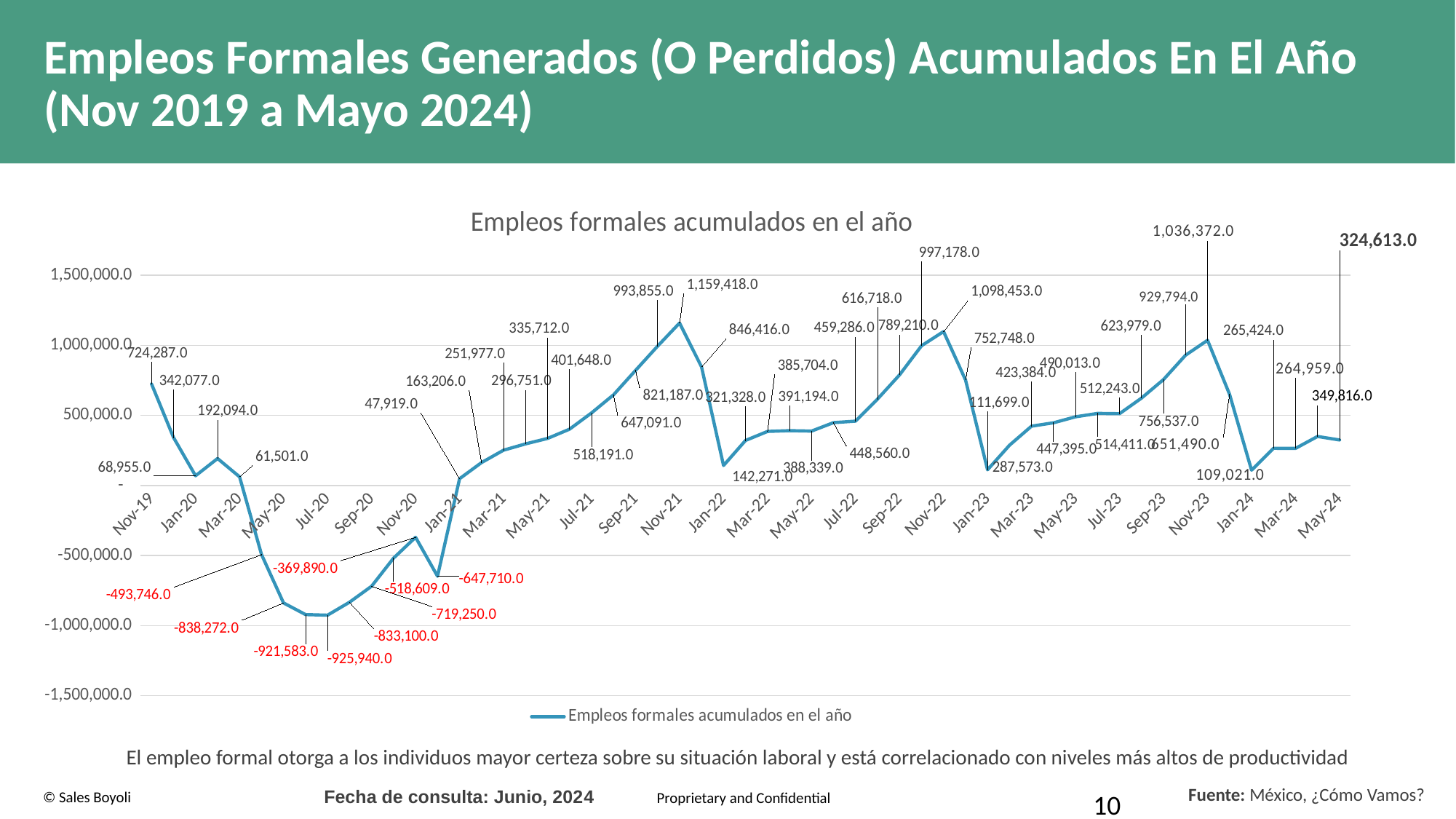
What is the value for Nov-19? 724,287.0 What is the difference between the values for Nov-19 and Dec-19? 382,210.0 Do the values rise or fall from Jan-21 to Nov-21? Rise What kind of chart is shown on the slide? Line chart How many series does the legend list? 1 What is the value for Jan-22? 142,271.0 Which month has the highest value on the chart? Nov-21 Which month has the lowest value on the chart? Jul-20 Is the value for Jul-20 greater or less than -500,000.0? less Which is larger, the value for Nov-22 or the value for Nov-23? Nov-22 What is the value for May-24? 324,613.0 What is the difference between the values for Nov-21 and Nov-22? 60,965.0